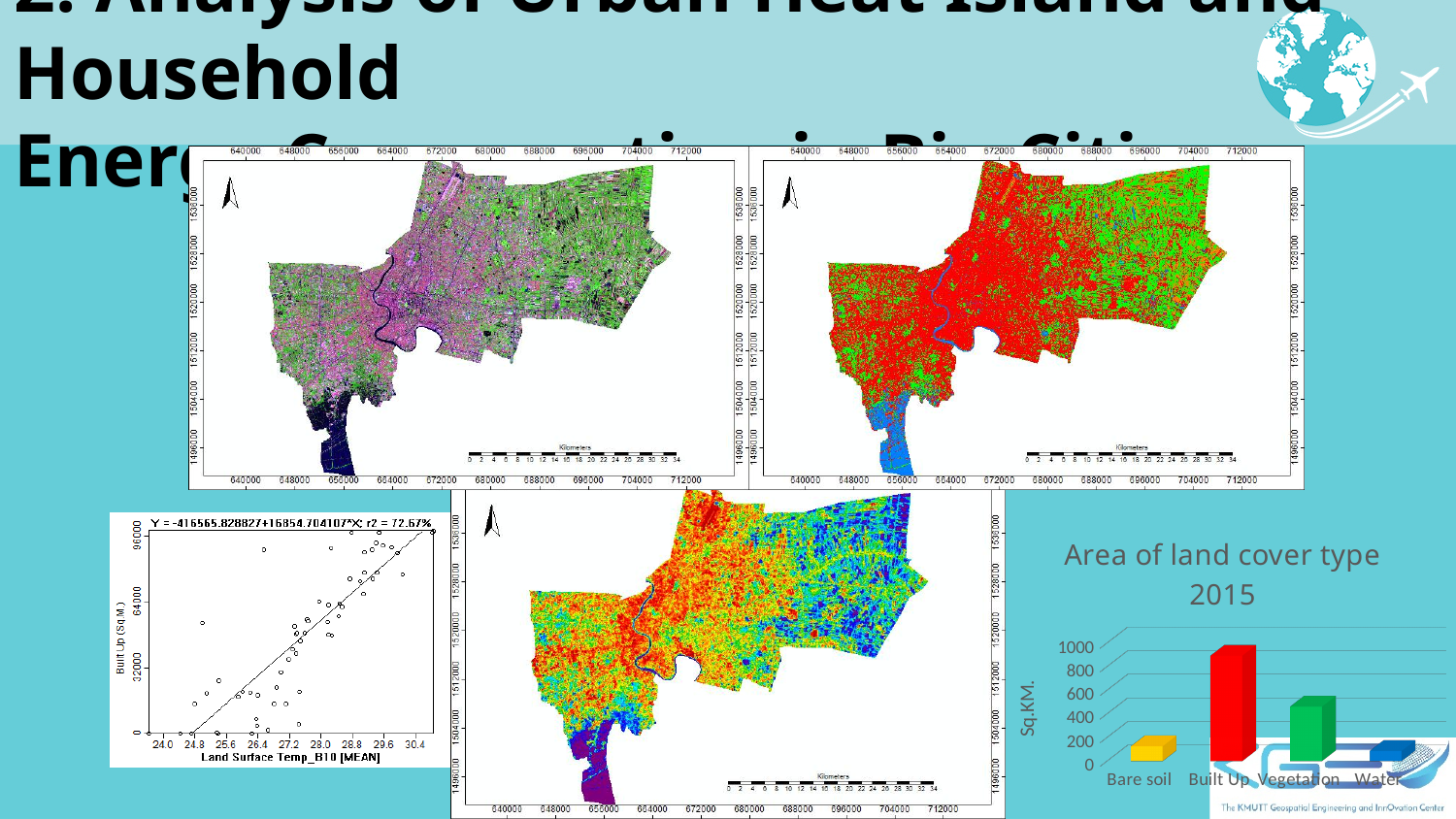
What unit is shown on the vertical axis of the 'Area of land cover type 2015' chart? Sq.KM. What kind of chart is the 'Area of land cover type 2015' chart? bar chart What r2 value is printed on the scatter plot in the bottom-left of the slide? 72.67% How many land cover categories are shown in the 'Area of land cover type 2015' chart? 4 What is the title of the bar chart on the right side of the slide? Area of land cover type 2015 In the 'Area of land cover type 2015' chart, is the value for Built Up greater or less than 800? greater In the 'Area of land cover type 2015' chart, is the value for Bare soil greater or less than 200? less What kind of chart is the one in the bottom-left of the slide plotting Built Up against Land Surface Temp? scatter plot In the 'Area of land cover type 2015' chart, is the value for Vegetation greater or less than 400? greater In the 'Area of land cover type 2015' chart, which land cover type has the largest area? Built Up In the 'Area of land cover type 2015' chart, which is larger, Built Up or Vegetation? Built Up